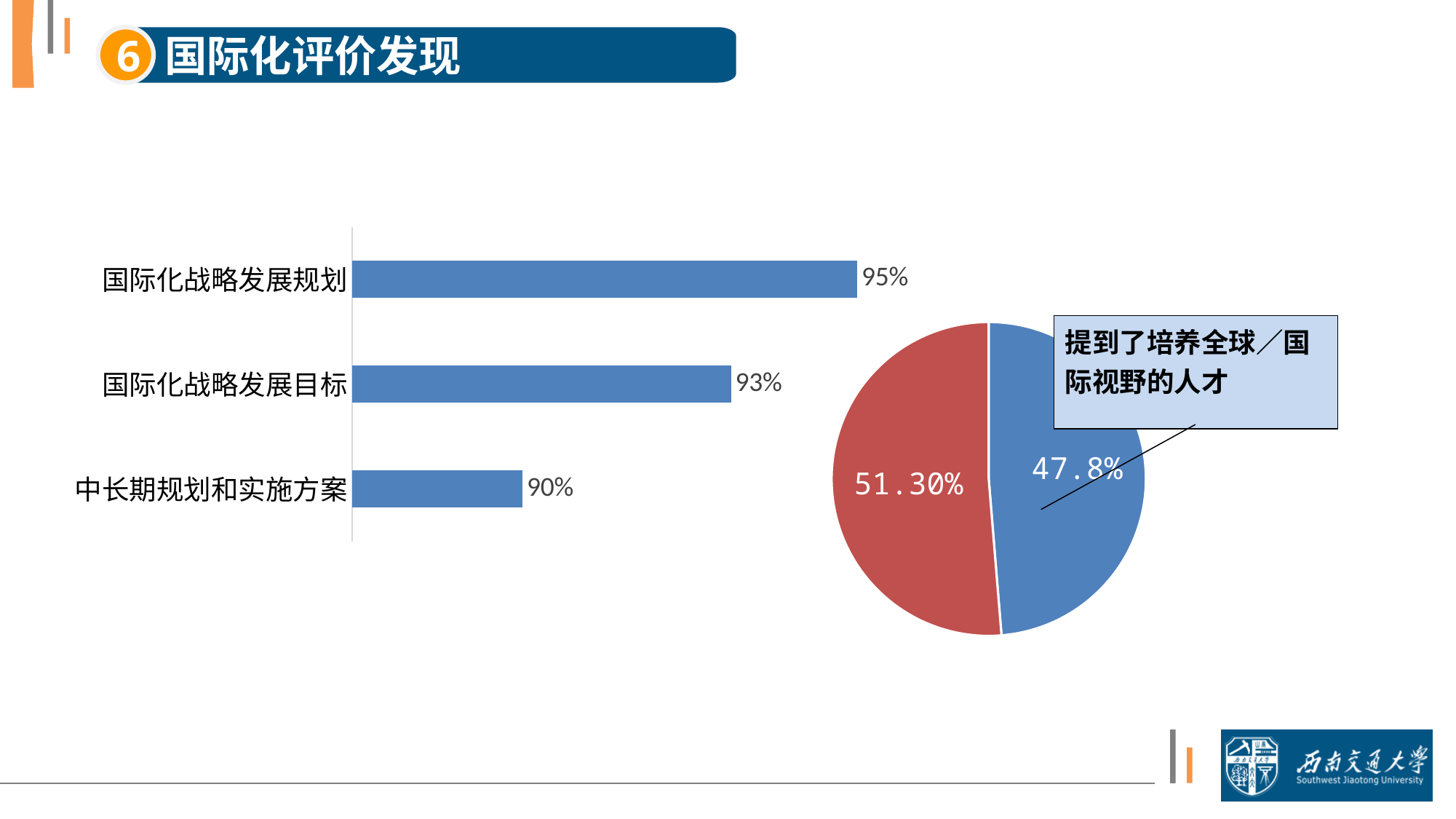
What kind of chart is on the left of the slide? Bar chart In the bar chart on the left, what is the value for 国际化战略发展目标? 93% In the pie chart on the right, what share is shown for the blue slice labelled 提到了培养全球／国际视野的人才? 47.8% In the bar chart on the left, which category has the lowest value? 中长期规划和实施方案 In the bar chart on the left, what is the value for 中长期规划和实施方案? 90% In the bar chart on the left, which category has the highest value? 国际化战略发展规划 In the bar chart on the left, what is the value for 国际化战略发展规划? 95% How many categories are shown in the bar chart on the left? 3 How many slices does the pie chart on the right have? 2 In the bar chart on the left, which is larger: the value for 国际化战略发展目标 or the value for 中长期规划和实施方案? 国际化战略发展目标 In the bar chart on the left, what is the difference between the values for 国际化战略发展规划 and 中长期规划和实施方案? 5% In the pie chart on the right, what share is shown for the red slice? 51.30%